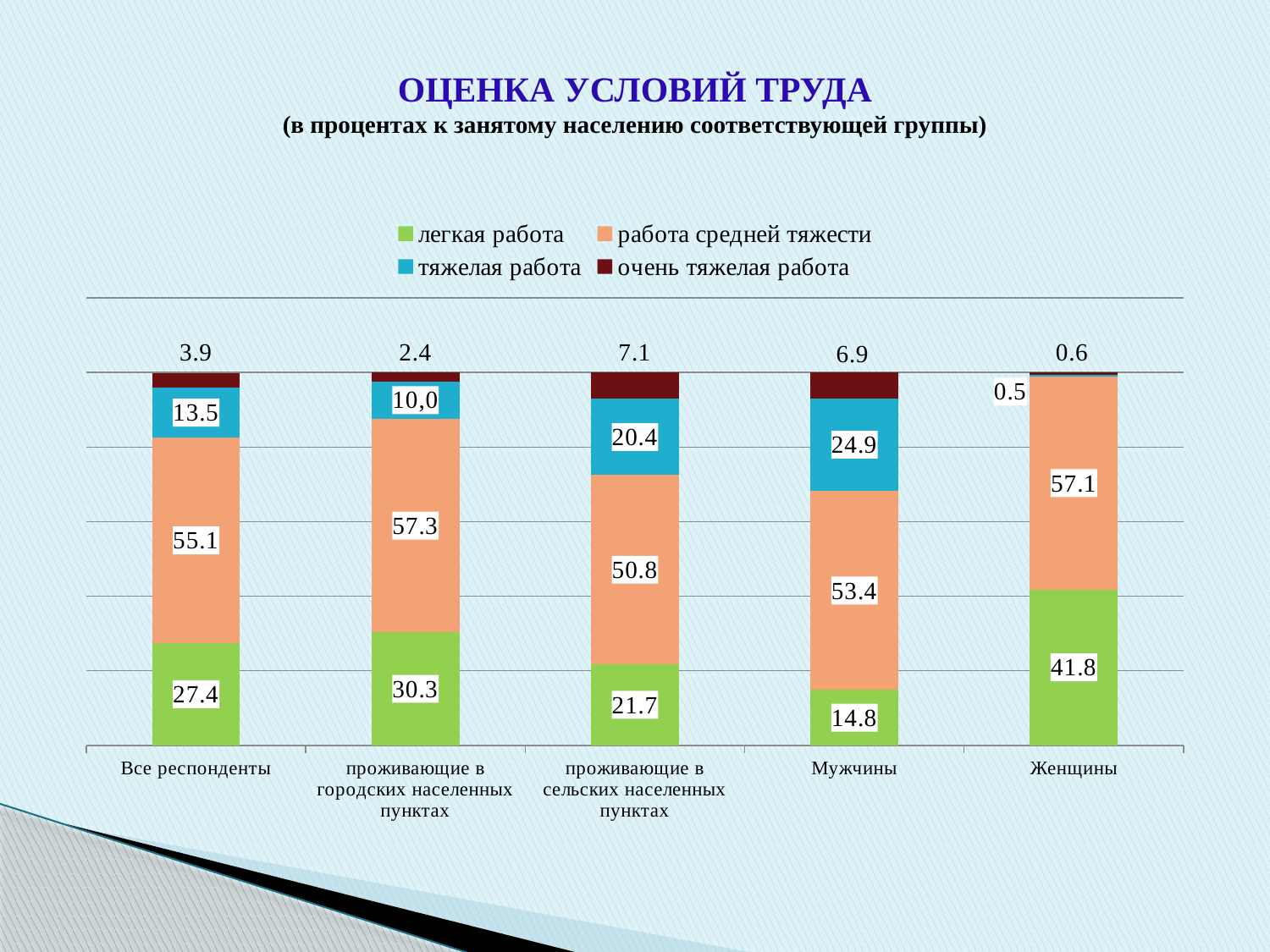
Which category has the lowest value for "тяжелая работа"? Женщины Which is larger: the "легкая работа" value for "Все респонденты" or for "Мужчины"? Все респонденты What is the difference between the "работа средней тяжести" values for "проживающие в городских населенных пунктах" and "проживающие в сельских населенных пунктах"? 6.5 What is the total of the stacked bar for "Мужчины"? 100.0 How many categories are shown along the x axis? 5 What is the value of "очень тяжелая работа" for "проживающие в сельских населенных пунктах"? 7.1 How many series does the legend list? 4 Which category has the highest value for "легкая работа"? Женщины What is the title of the chart? ОЦЕНКА УСЛОВИЙ ТРУДА What is the value of "легкая работа" for "Женщины"? 41.8 What is the value of "тяжелая работа" for "Мужчины"? 24.9 What kind of chart is shown on the slide? stacked bar chart